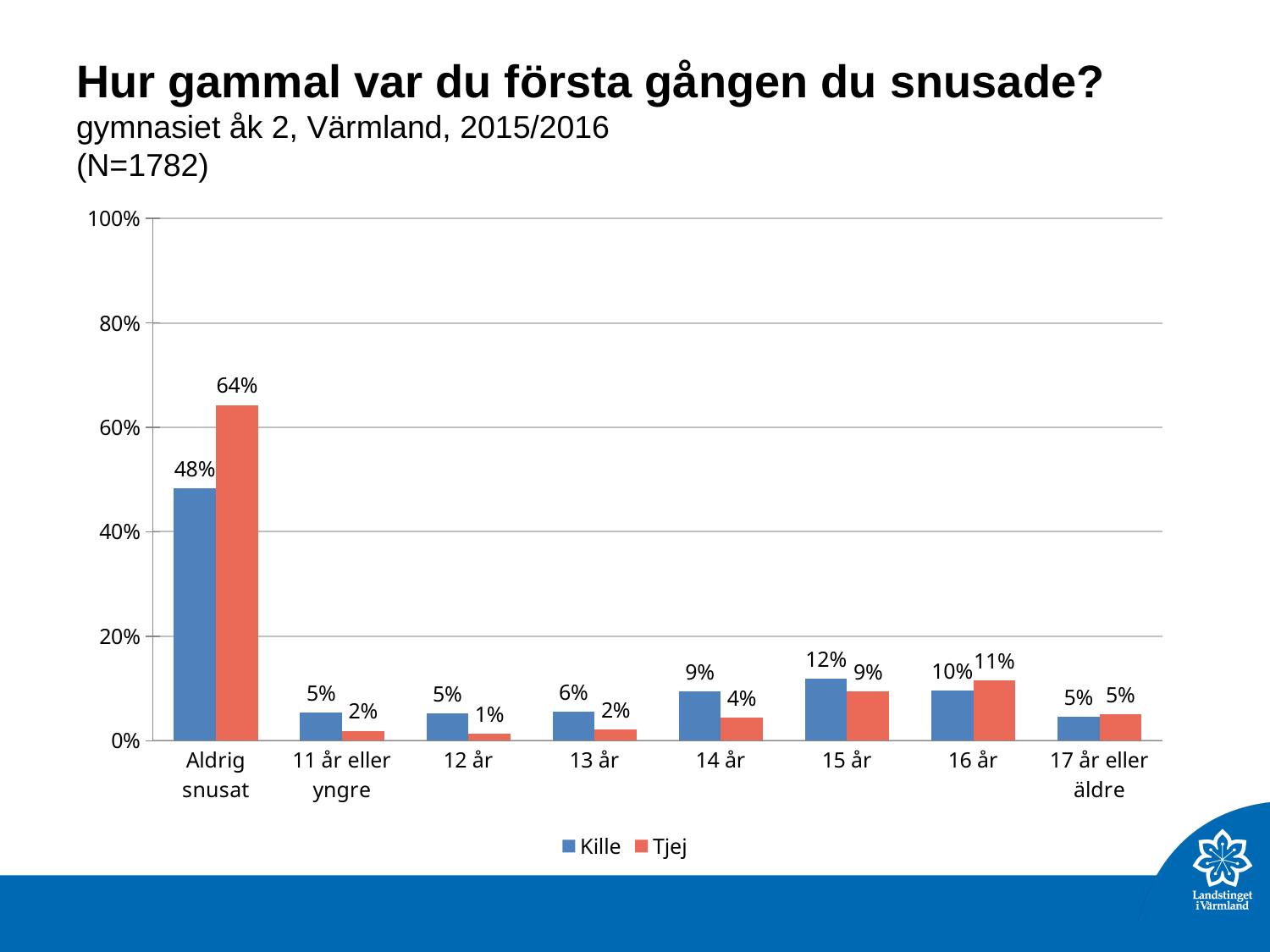
What is the value for Tjej at "14 år"? 4% Is the value for Tjej in "Aldrig snusat" greater or less than 60%? greater Which category has the lowest value for Tjej? 12 år Which is larger at "16 år": the Kille value or the Tjej value? Tjej What kind of chart is shown on the slide? Bar chart What is the value for Kille in the "Aldrig snusat" category? 48% What is the value for Tjej in the "Aldrig snusat" category? 64% What is the value for Kille at "15 år"? 12% Which category has the highest value for Tjej? Aldrig snusat How many categories are shown on the x axis? 8 What is the difference between the Tjej and Kille values in the "Aldrig snusat" category? 16% How many series does the legend list? 2